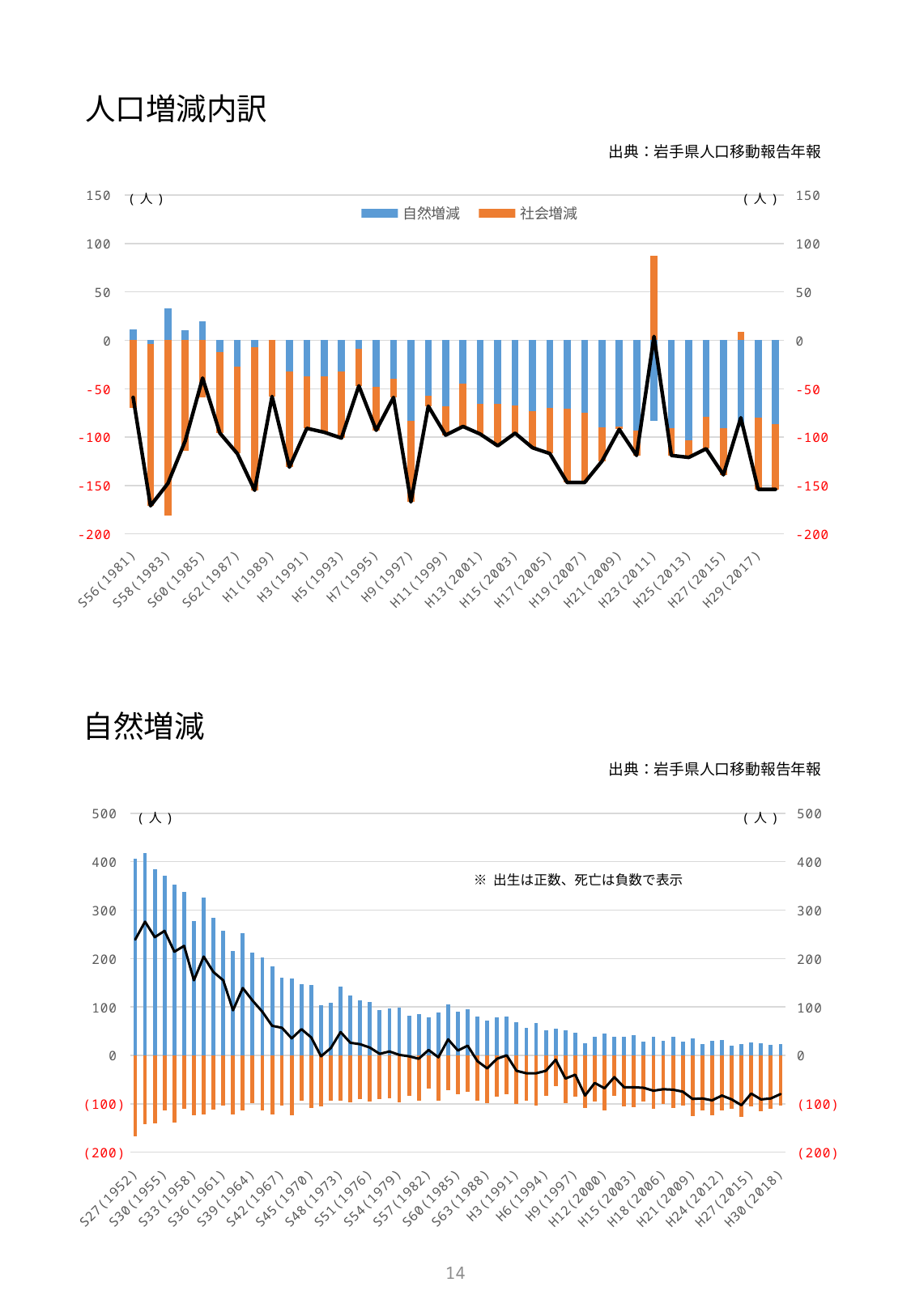
In the bottom chart titled 自然増減, is the orange bar value for S27(1952) greater or less than -100? less What source is cited for both charts on the slide? 岩手県人口移動報告年報 In the top chart titled 人口増減内訳, what kind of chart is used for the 自然増減 and 社会増減 series? Stacked bar chart (with a line overlay) In the bottom chart titled 自然増減, is the blue bar value for S27(1952) greater or less than 300? greater In the top chart titled 人口増減内訳, how many series does the legend list? 2 In the bottom chart titled 自然増減, is the black line value for S27(1952) greater or less than 200? greater In the top chart titled 人口増減内訳, what are the two legend entries? 自然増減 and 社会増減 In the bottom chart titled 自然増減, do the blue (positive) bars generally rise or fall from S27(1952) to H30(2018)? Fall In the top chart titled 人口増減内訳, which colour represents 社会増減? Orange